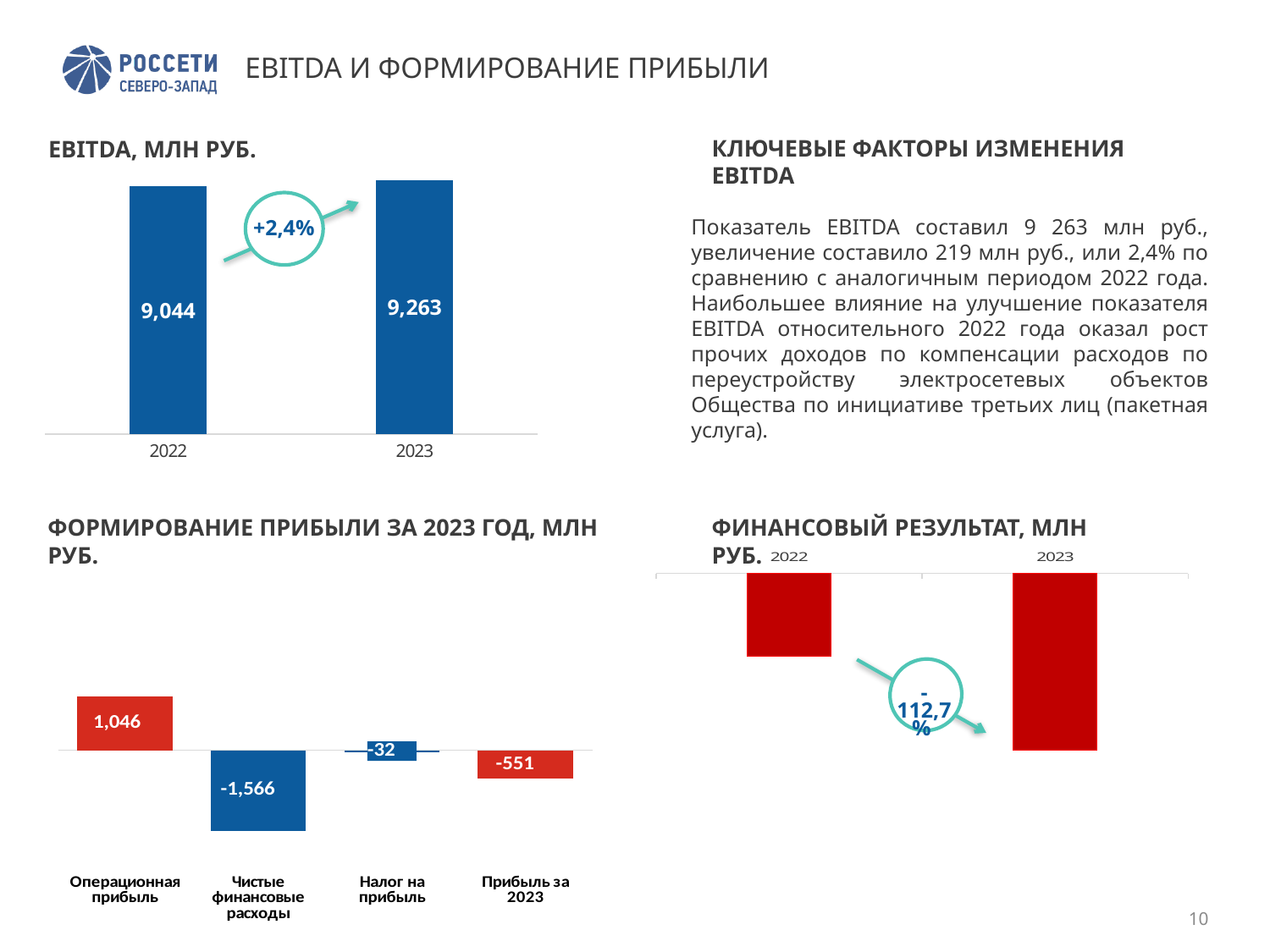
In the 'EBITDA, МЛН РУБ.' chart, what is the value for 2022? 9,044 In the 'EBITDA, МЛН РУБ.' chart, what is the difference between the 2023 and 2022 values? 219 In the 'ФОРМИРОВАНИЕ ПРИБЫЛИ ЗА 2023 ГОД, МЛН РУБ.' chart, which category has the lowest value? Чистые финансовые расходы In the 'EBITDA, МЛН РУБ.' chart, what is the value for 2023? 9,263 How many categories are shown in the 'ФОРМИРОВАНИЕ ПРИБЫЛИ ЗА 2023 ГОД, МЛН РУБ.' chart? 4 What type of chart is the 'EBITDA, МЛН РУБ.' chart? Bar chart In the 'ФОРМИРОВАНИЕ ПРИБЫЛИ ЗА 2023 ГОД, МЛН РУБ.' chart, what is the value for Налог на прибыль? -32 In the 'EBITDA, МЛН РУБ.' chart, which year has the higher value? 2023 In the 'ФОРМИРОВАНИЕ ПРИБЫЛИ ЗА 2023 ГОД, МЛН РУБ.' chart, what is the value for Прибыль за 2023? -551 In the 'ФОРМИРОВАНИЕ ПРИБЫЛИ ЗА 2023 ГОД, МЛН РУБ.' chart, what is the value for Операционная прибыль? 1,046 In the 'ФОРМИРОВАНИЕ ПРИБЫЛИ ЗА 2023 ГОД, МЛН РУБ.' chart, what is the value for Чистые финансовые расходы? -1,566 In the 'EBITDA, МЛН РУБ.' chart, what percentage change is shown between 2022 and 2023? +2,4%